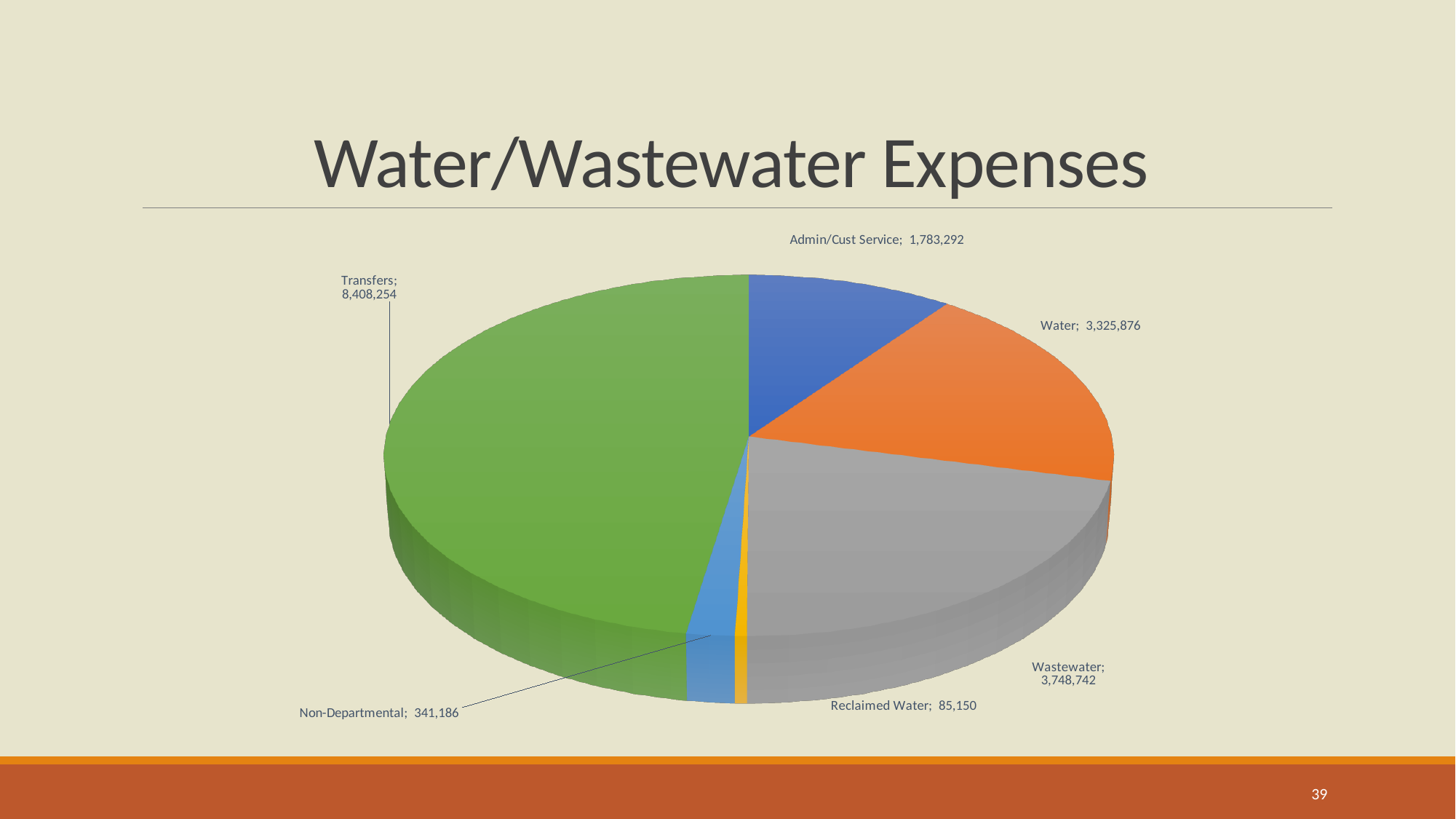
Which category has the largest expense? Transfers What is the value for Transfers? 8,408,254 What is the value for Wastewater? 3,748,742 What type of chart is shown on the slide? Pie chart What is the value for Reclaimed Water? 85,150 What is the title of the chart? Water/Wastewater Expenses Which is larger, Water or Wastewater? Wastewater What is the value for Admin/Cust Service? 1,783,292 What is the difference between the Wastewater and Water values? 422,866 What is the difference between the Transfers and Admin/Cust Service values? 6,624,962 Which category has the smallest expense? Reclaimed Water How many categories (slices) does the pie chart have? 6